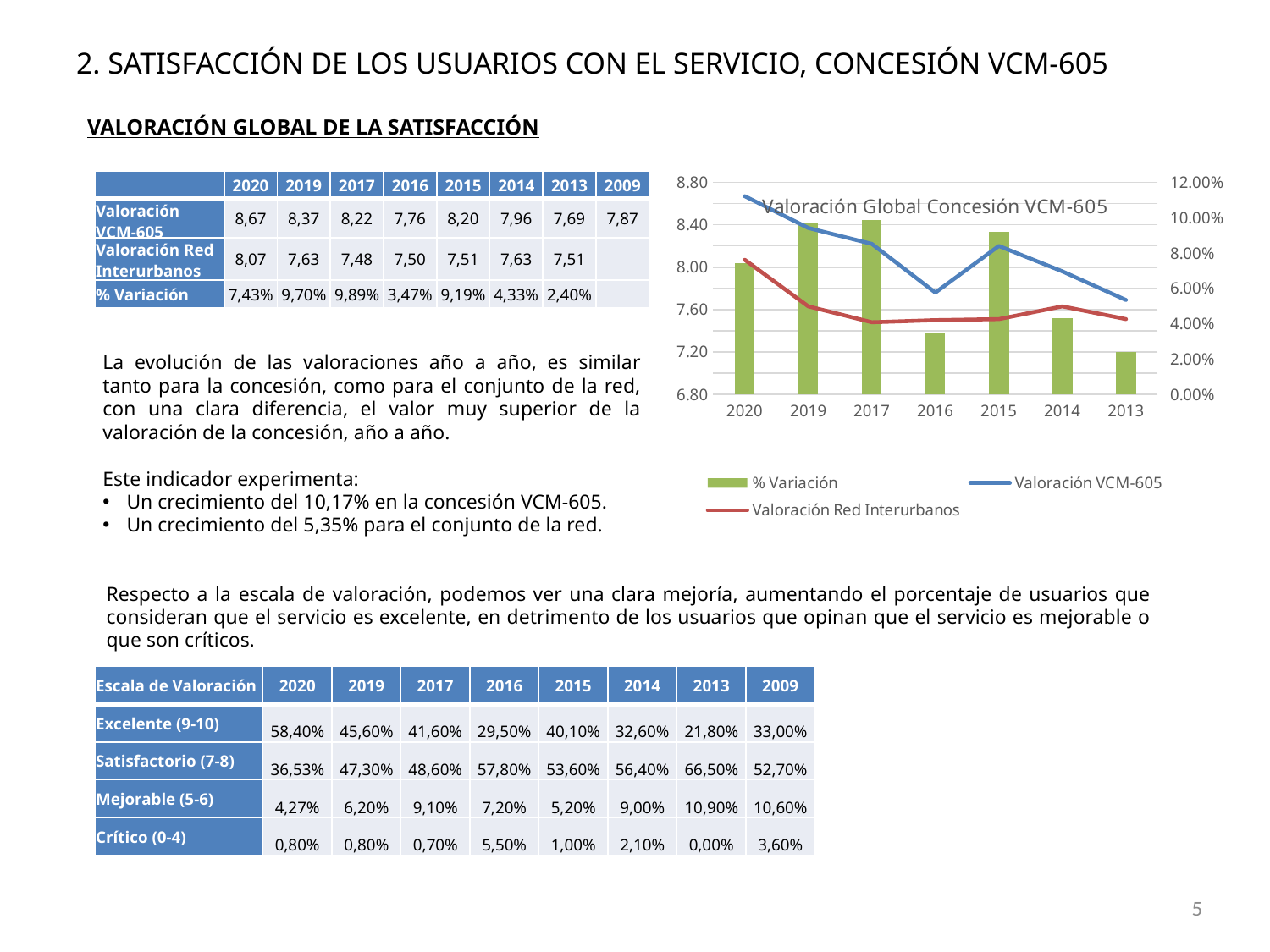
Which series in the chart is drawn as bars? % Variación In which year is the % Variación bar the lowest? 2013 In which year does the Valoración VCM-605 line reach its highest value? 2020 In 2020, which line is higher: Valoración VCM-605 or Valoración Red Interurbanos? Valoración VCM-605 What kind of chart is shown on the slide? Combined bar and line chart Is the % Variación bar for 2019 greater or less than 8.00%? greater How many series does the legend of the chart list? 3 What is the title of the chart on the right of the slide? Valoración Global Concesión VCM-605 Is the % Variación bar for 2016 greater or less than 4.00%? less How many years are shown on the x axis of the chart? 7 Does the Valoración VCM-605 line generally rise or fall moving from 2020 to 2013 along the x axis? fall Is the Valoración VCM-605 value for 2016 greater or less than 8.00? less